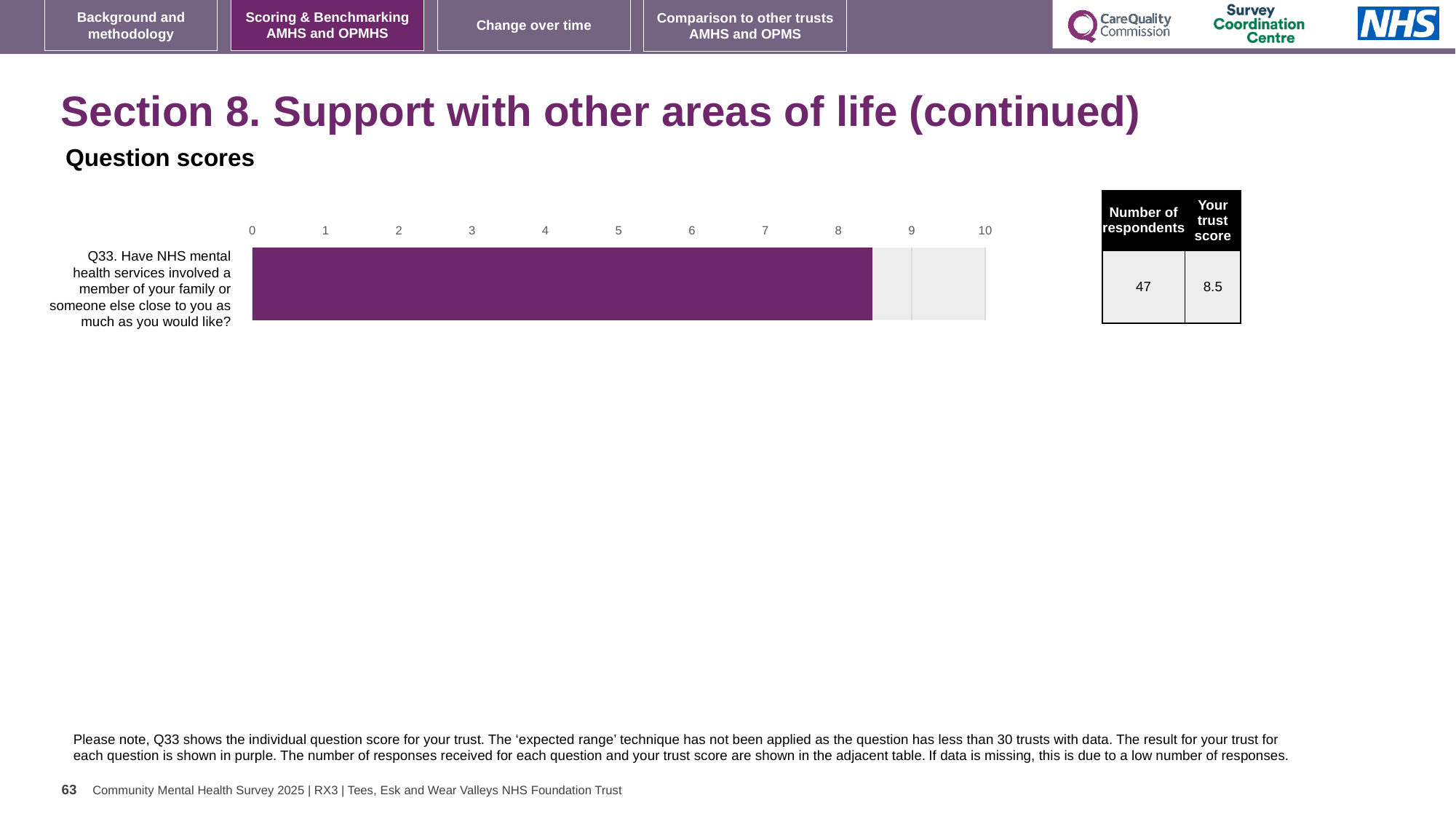
Is the value of the bar for Q33 greater or less than 8? greater What is the maximum value shown on the chart's axis? 10 Is the value of the bar for Q33 greater or less than 9? less What is the trust score for Q33 shown on the slide? 8.5 What kind of chart is shown on the slide? Bar chart Is the value of the bar for Q33 greater or less than 5? greater What colour is the bar for Q33? Purple Which question number is plotted in the chart? Q33 How many questions (categories) are plotted in the chart? 1 How many respondents answered Q33 according to the table next to the chart? 47